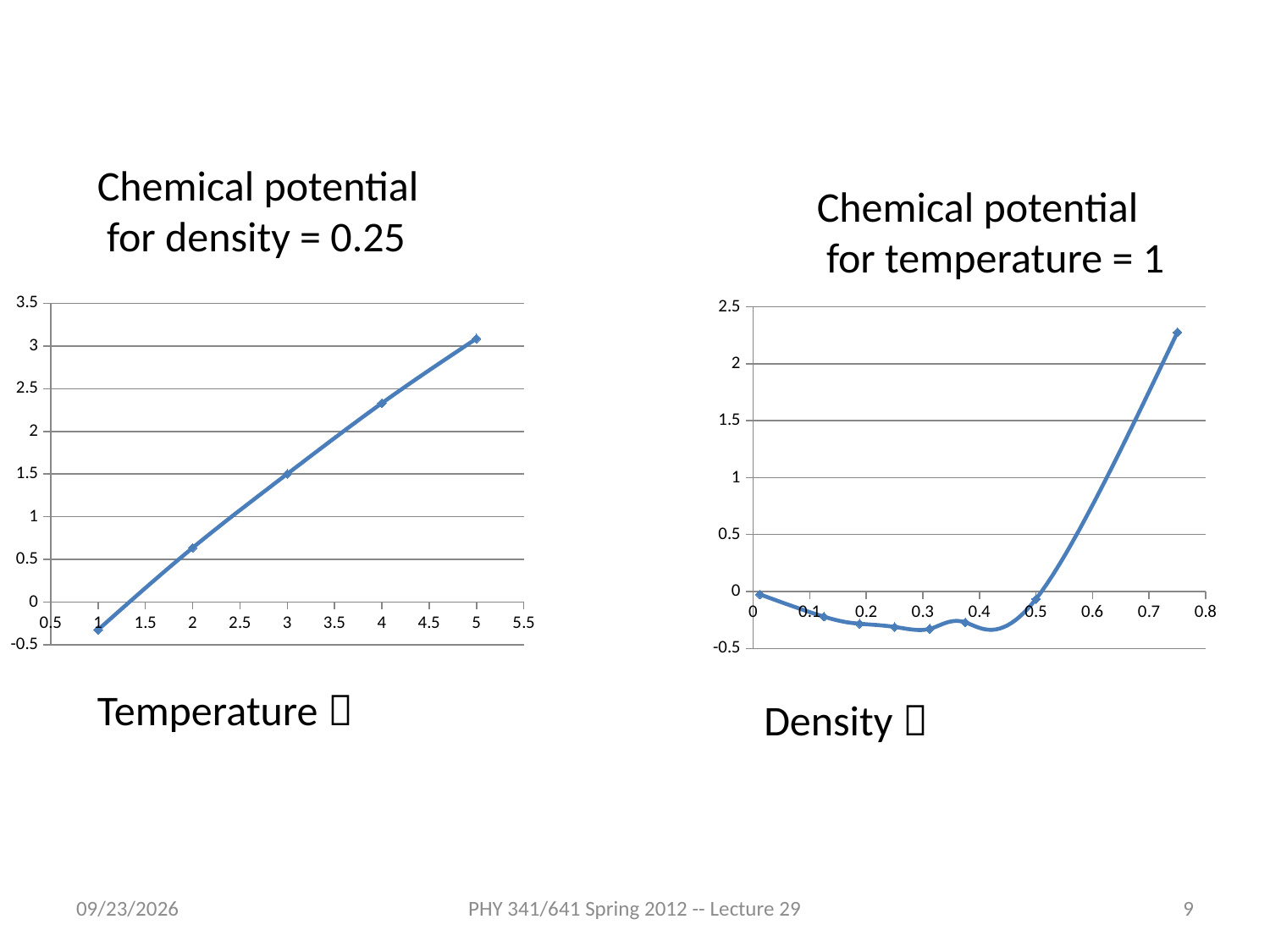
What is the title of the chart on the right side of the slide? Chemical potential for temperature = 1 On the 'Chemical potential for temperature = 1' chart, is the value at density 0.75 greater or less than 2? greater On the 'Chemical potential for temperature = 1' chart, which has the larger chemical potential: density 0.5 or density 0.75? 0.75 On the 'Chemical potential for temperature = 1' chart, is the value at density 0.3 greater or less than 0? less On the 'Chemical potential for density = 0.25' chart, at which temperature is the chemical potential lowest? 1 On the 'Chemical potential for density = 0.25' chart, at which temperature is the chemical potential highest? 5 What kind of chart is the 'Chemical potential for density = 0.25' chart? line chart On the 'Chemical potential for temperature = 1' chart, at which density is the chemical potential highest? 0.75 On the 'Chemical potential for density = 0.25' chart, is the value at temperature 5 greater or less than 3? greater How many data points are plotted on the 'Chemical potential for density = 0.25' chart? 5 On the 'Chemical potential for density = 0.25' chart, do the values rise or fall as temperature increases? rise